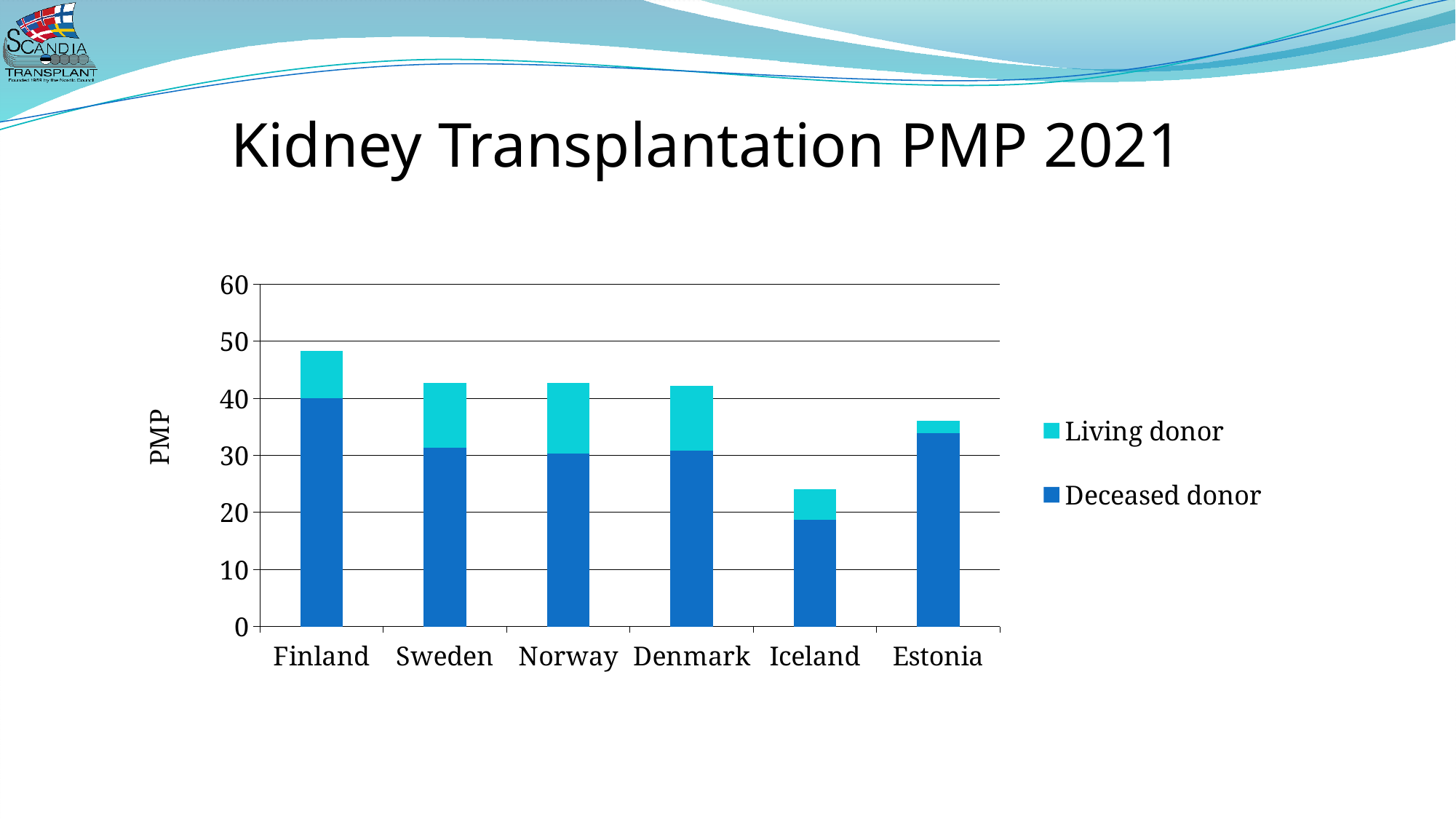
Which country has the highest total kidney transplantation PMP? Finland Which country has the largest deceased donor segment? Finland Is the total value for Iceland greater or less than 30? less How many countries are shown on the x axis of the chart? 6 Which is larger, the total for Finland or the total for Estonia? Finland Is the total value for Finland greater or less than 40? greater What type of chart is shown on the slide? Stacked bar chart Which country has the lowest total kidney transplantation PMP? Iceland Which country has the smallest living donor segment? Estonia What is the label on the y axis of the chart? PMP Is the deceased donor value for Estonia greater or less than 30? greater How many series does the legend list? 2